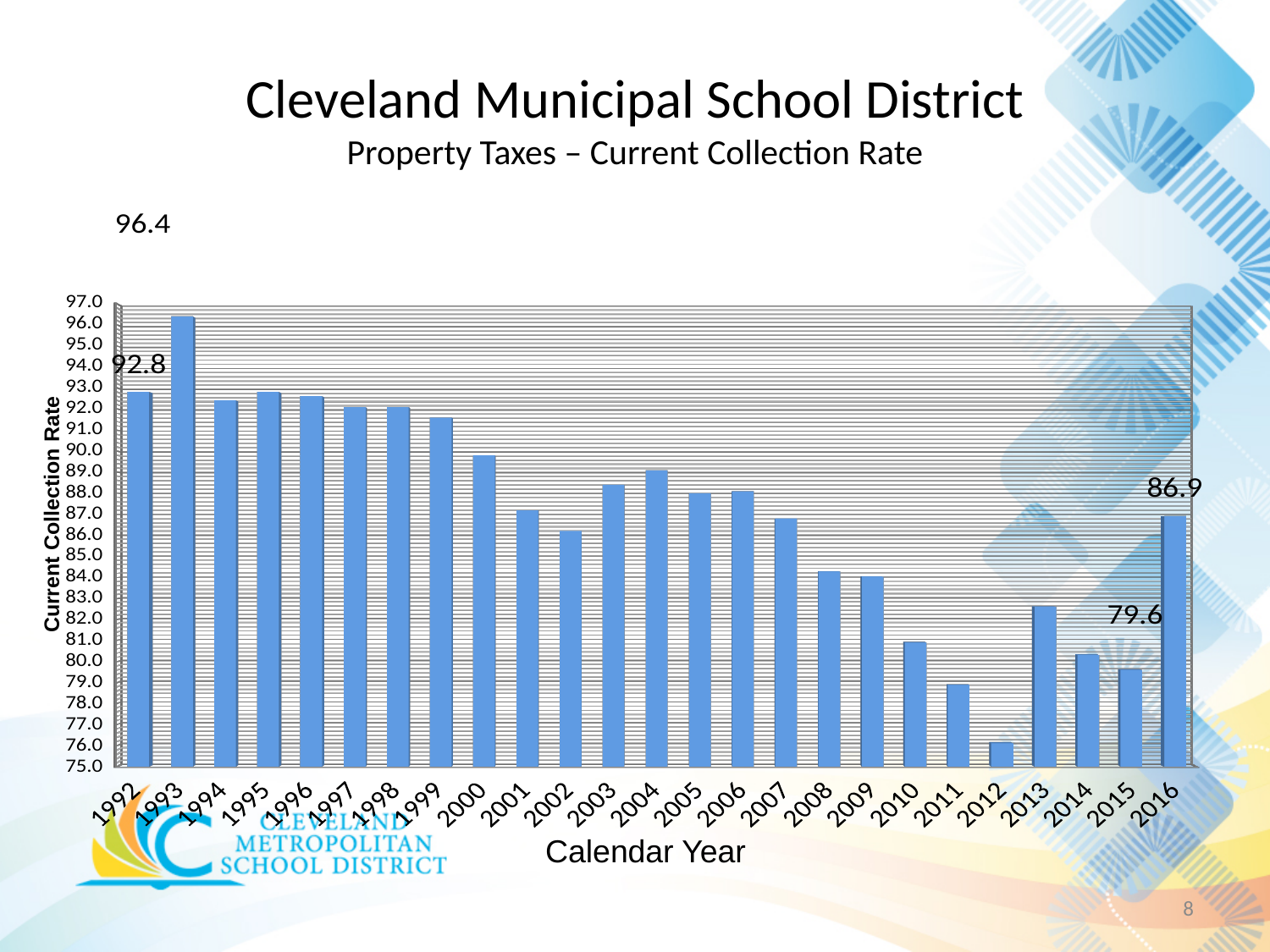
Is the collection rate for 2011 greater or less than 80.0? less What is the current collection rate for 1993? 96.4 What kind of chart is shown on the slide? Bar chart How many calendar years are plotted on the chart? 25 What is the current collection rate for 1992? 92.8 What is the current collection rate for 2015? 79.6 Which year has the larger collection rate, 1992 or 2016? 1992 Which calendar year has the highest current collection rate? 1993 What is the current collection rate for 2016? 86.9 By how much does the collection rate for 2016 exceed the rate for 2015? 7.3 Which calendar year has the lowest current collection rate? 2012